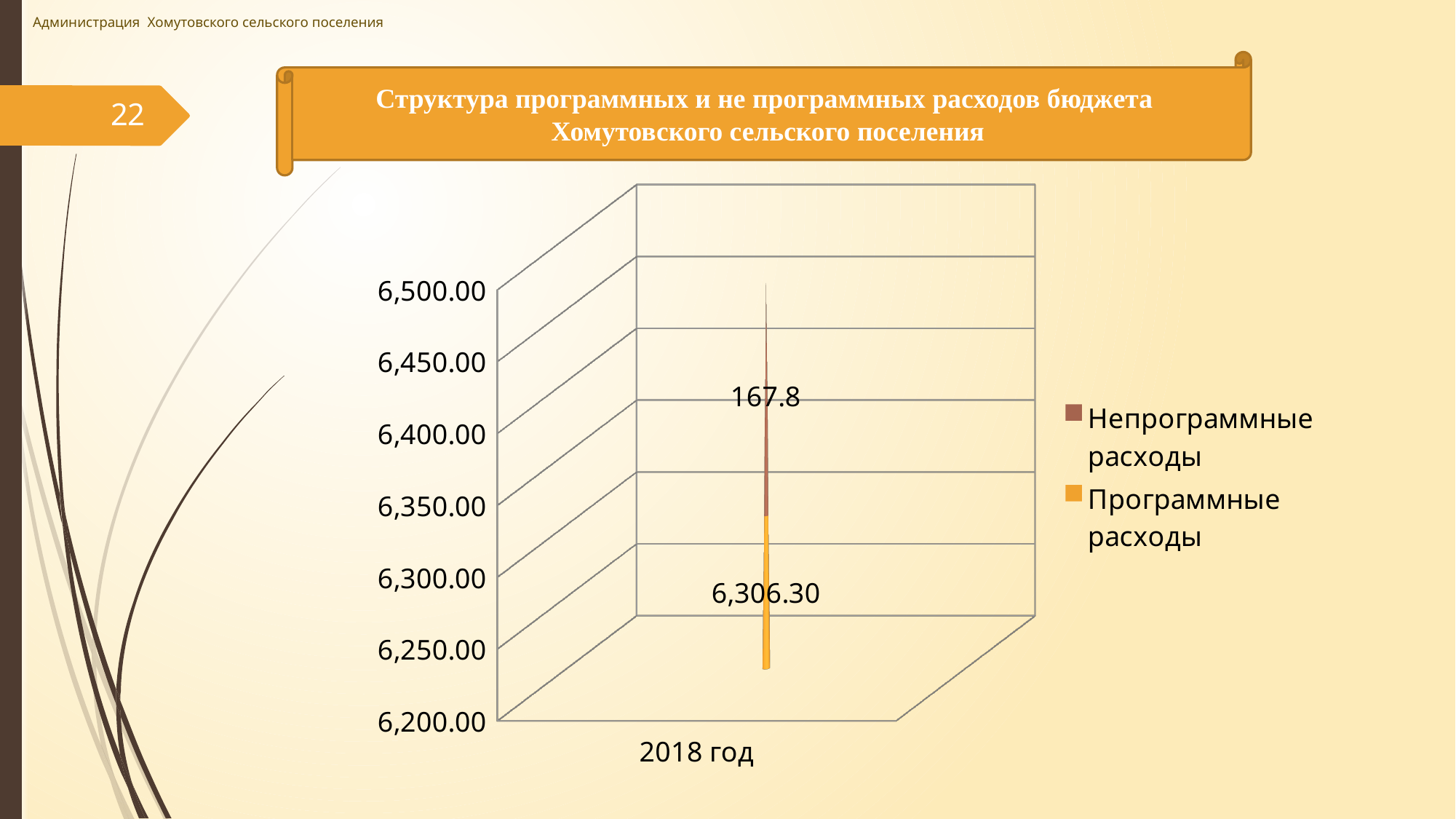
What is the total of the stacked bar for 2018 год? 6,474.1 What is the title of the chart on the slide? Структура программных и не программных расходов бюджета Хомутовского сельского поселения Which series has the larger value in 2018 год, Программные расходы or Непрограммные расходы? Программные расходы How many series does the legend list? 2 What kind of chart is shown on the slide? Bar chart Which colour represents Программные расходы in the legend? Orange What is the difference between Программные расходы and Непрограммные расходы in 2018 год? 6,138.5 What is the value for Непрограммные расходы in 2018 год? 167.8 Which series has the smallest value in 2018 год? Непрограммные расходы What is the value for Программные расходы in 2018 год? 6,306.30 How many categories are shown on the x axis? 1 Which series has the largest value in 2018 год? Программные расходы